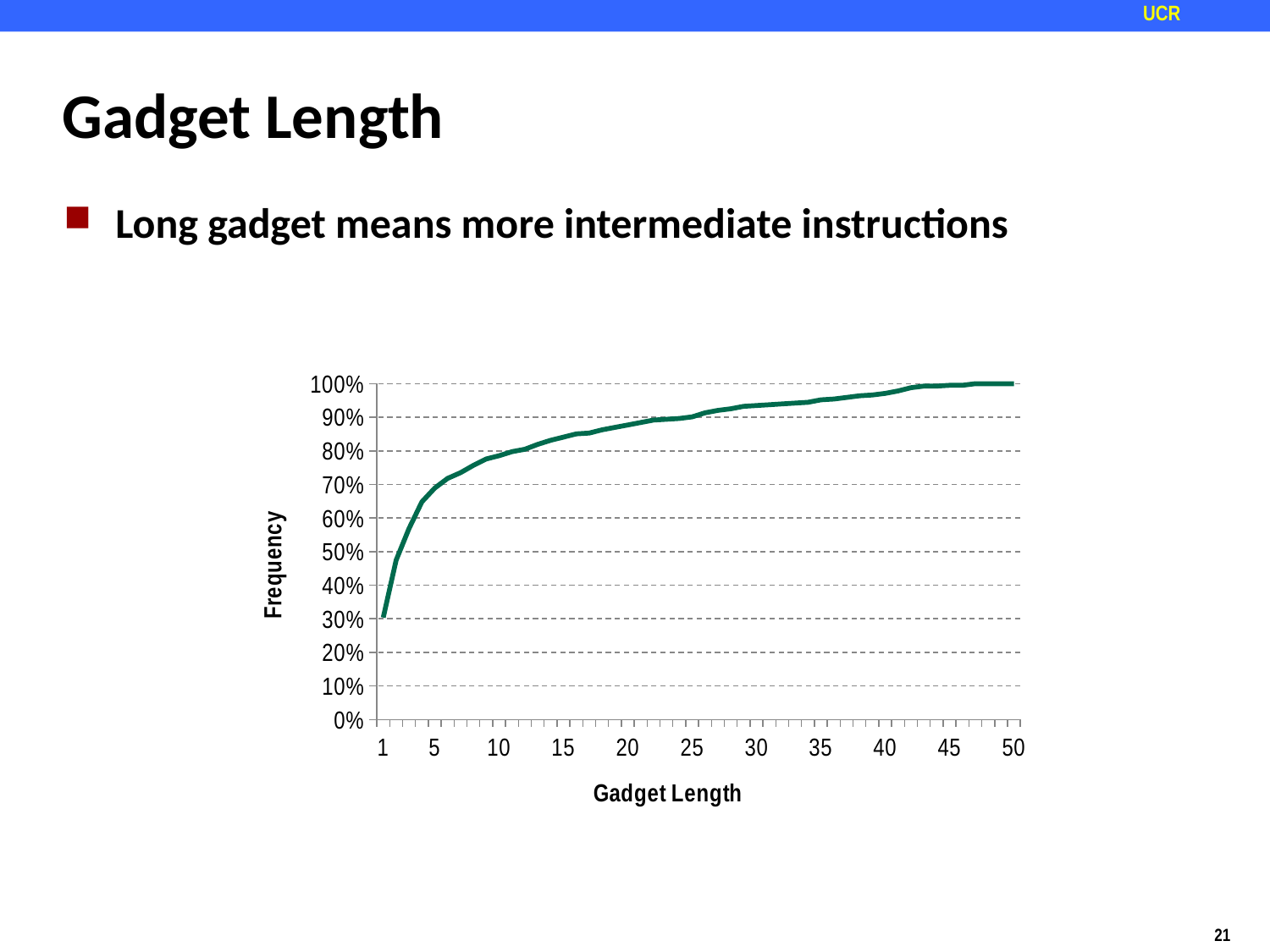
What kind of chart is shown on the slide? line chart Is the frequency at gadget length 25 greater or less than 80%? greater Is the frequency at gadget length 15 greater or less than 90%? less What is the label on the y axis of the chart? Frequency Which has the higher frequency, gadget length 5 or gadget length 10? gadget length 10 What is the label on the x axis of the chart? Gadget Length Is the frequency at gadget length 1 greater or less than 40%? less What is the frequency value at gadget length 50? 100% Does the frequency rise or fall as gadget length increases along the x axis? rises